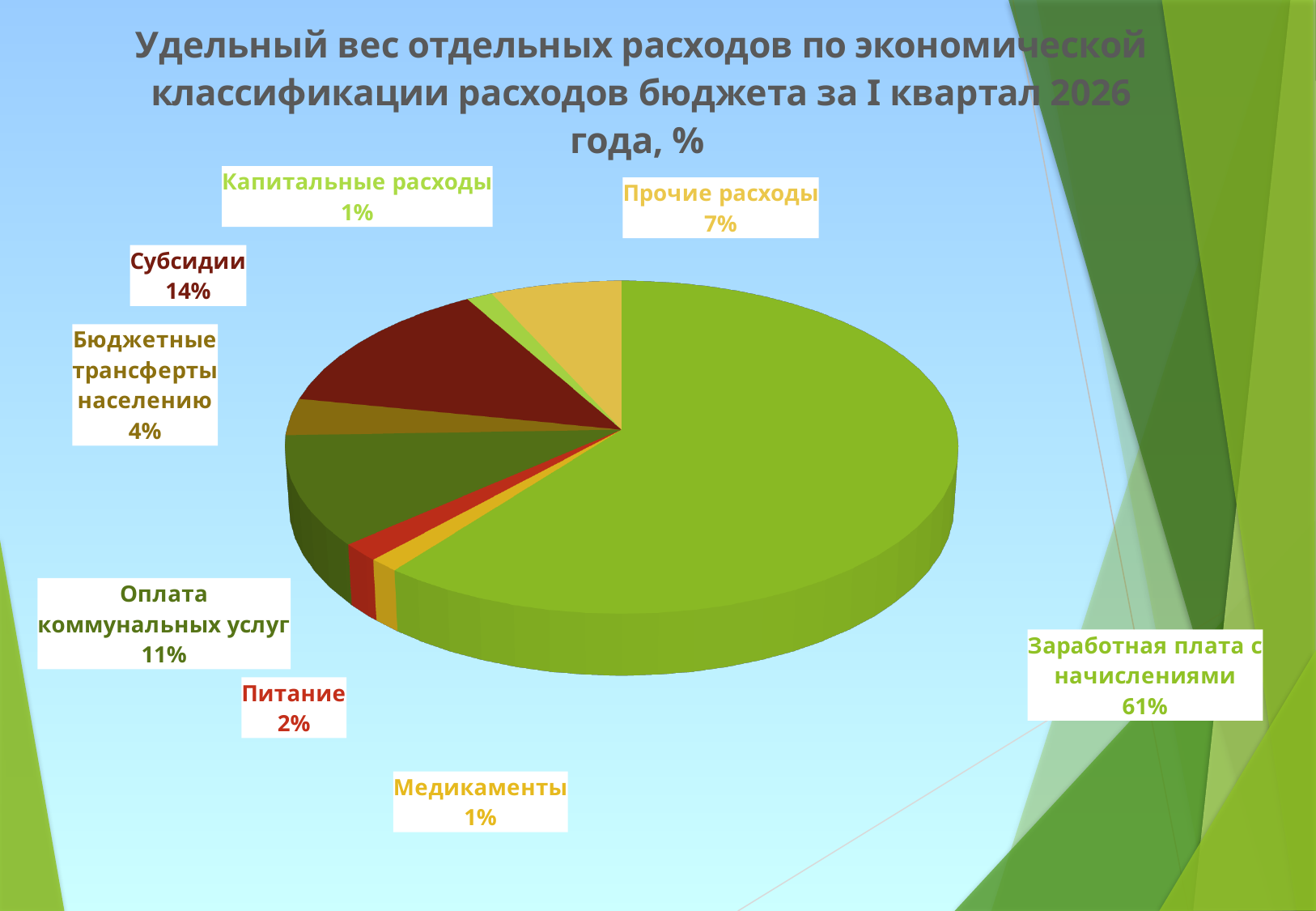
What is the value shown for "Субсидии"? 14% What percentage is shown for "Оплата коммунальных услуг"? 11% Which is larger: "Субсидии" or "Оплата коммунальных услуг"? Субсидии What is the difference between the shares of "Субсидии" and "Прочие расходы"? 7% Which two categories each have a share of 1%? Капитальные расходы and Медикаменты For which quarter and year does the chart title say the data is shown? I квартал 2026 года How many categories are labelled in the pie chart? 8 What is the value for "Прочие расходы"? 7% What share does "Заработная плата с начислениями" have in the pie chart? 61% Which category has the largest share of the pie? Заработная плата с начислениями What share is shown for "Бюджетные трансферты населению"? 4% What type of chart is shown on the slide? Pie chart